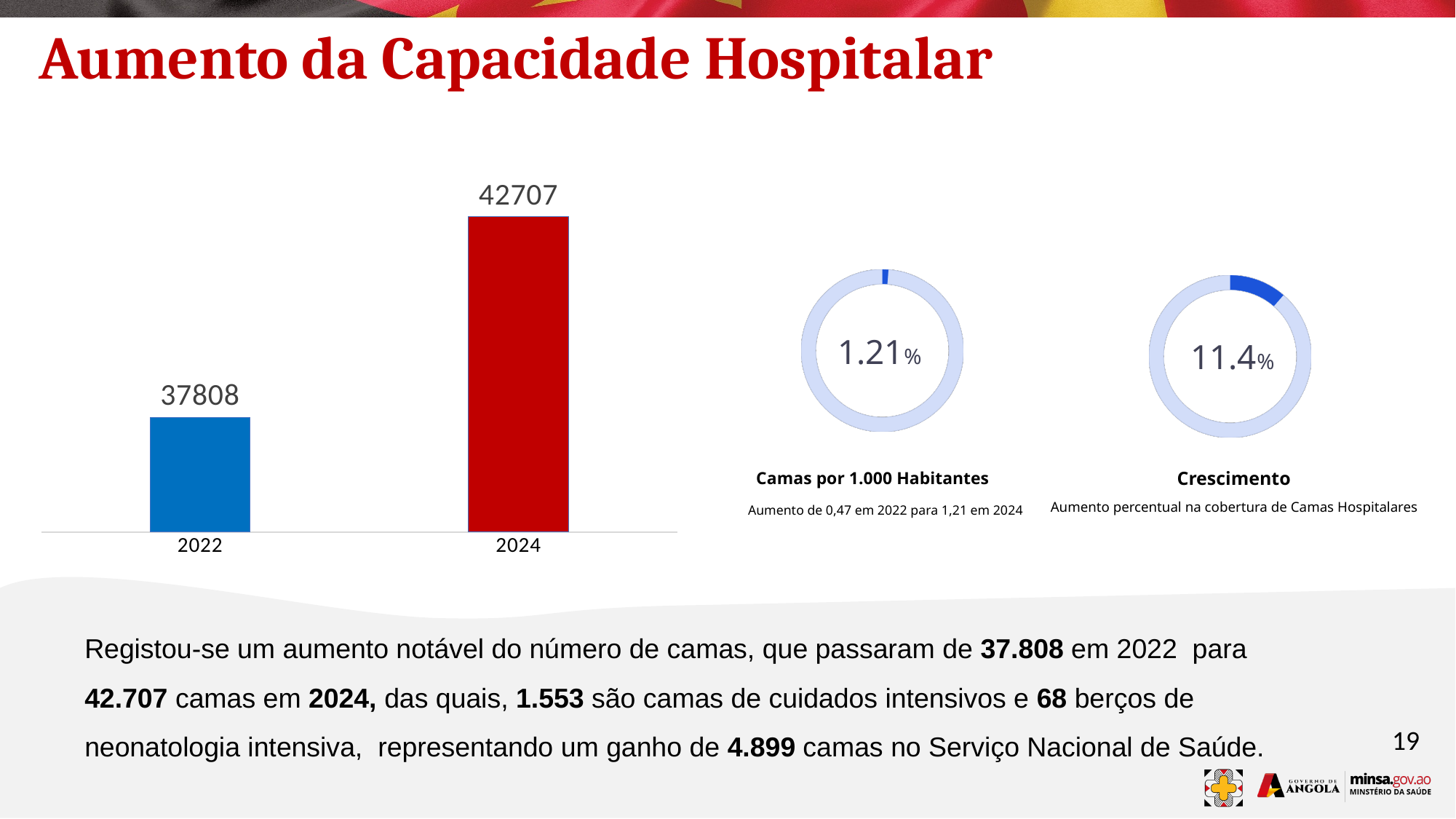
What kind of chart is the chart on the left of the slide? Bar chart In the bar chart on the left, what is the value for 2022? 37808 In the bar chart on the left, what is the difference between the 2024 and 2022 values? 4899 In the bar chart on the left, which year has the lowest value? 2022 In the bar chart on the left, what colour is the bar for 2024? Red In the bar chart on the left, what is the value for 2024? 42707 In the bar chart on the left, which is larger, the value for 2022 or the value for 2024? 2024 In the bar chart on the left, do the values rise or fall from 2022 to 2024? Rise In the bar chart on the left, which year has the highest value? 2024 In the ring chart labelled 'Crescimento', what value is shown in the centre? 11.4% How many bars are shown in the bar chart on the left? 2 In the ring chart labelled 'Camas por 1.000 Habitantes', what value is shown in the centre? 1.21%